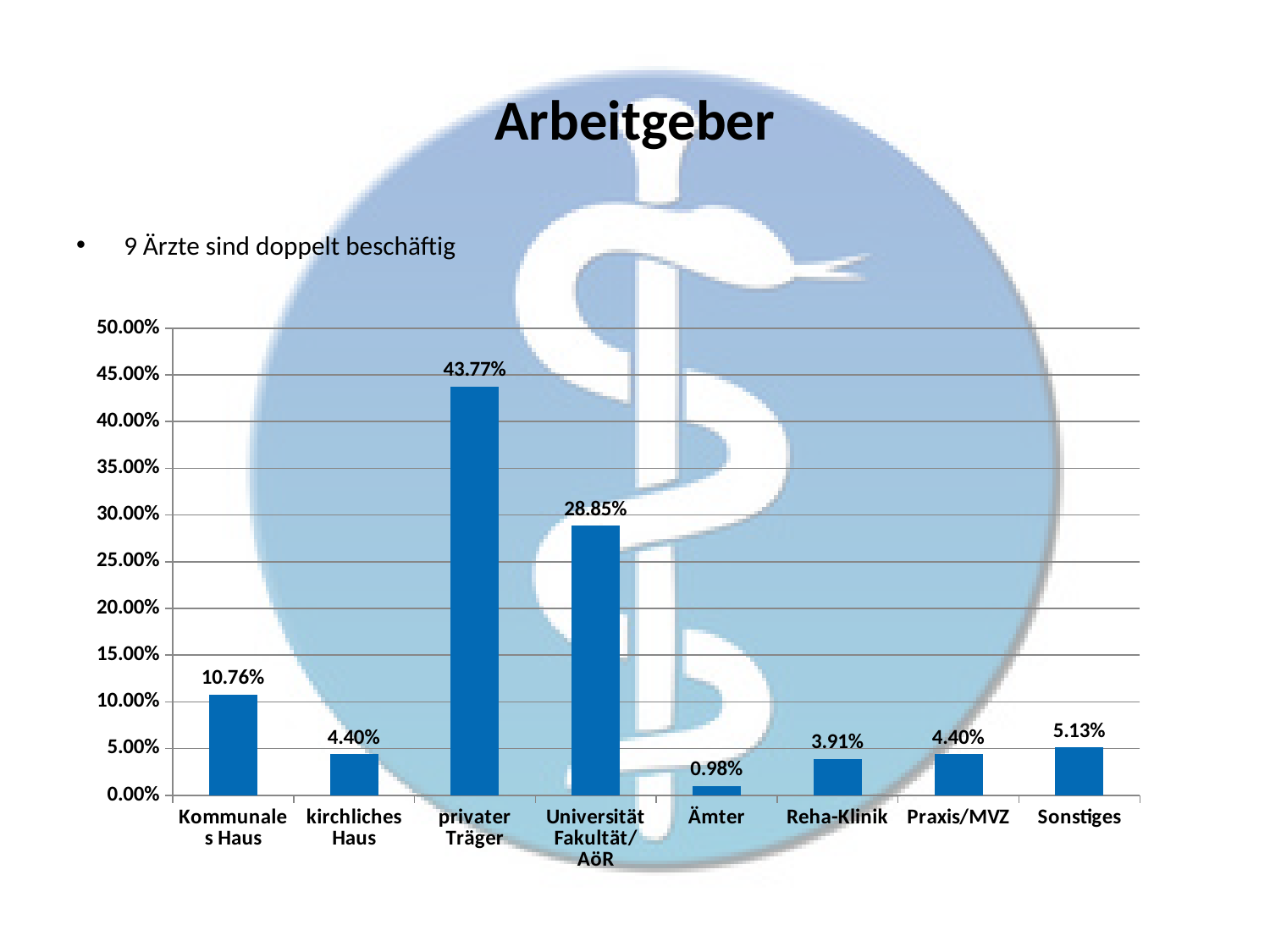
Which category has the lowest value? Ämter How many categories are shown on the x axis? 8 What is the title of the slide? Arbeitgeber What is the value for Reha-Klinik? 3.91% What is the value for privater Träger? 43.77% What kind of chart is shown on the slide? bar chart What is the value for Kommunales Haus? 10.76% Is the value for Universität Fakultät/AöR greater or less than 25.00%? greater Which category has the highest value? privater Träger Which is larger, the value for Sonstiges or the value for Reha-Klinik? Sonstiges What is the difference between the values for privater Träger and Universität Fakultät/AöR? 14.92% What is the value for Ämter? 0.98%